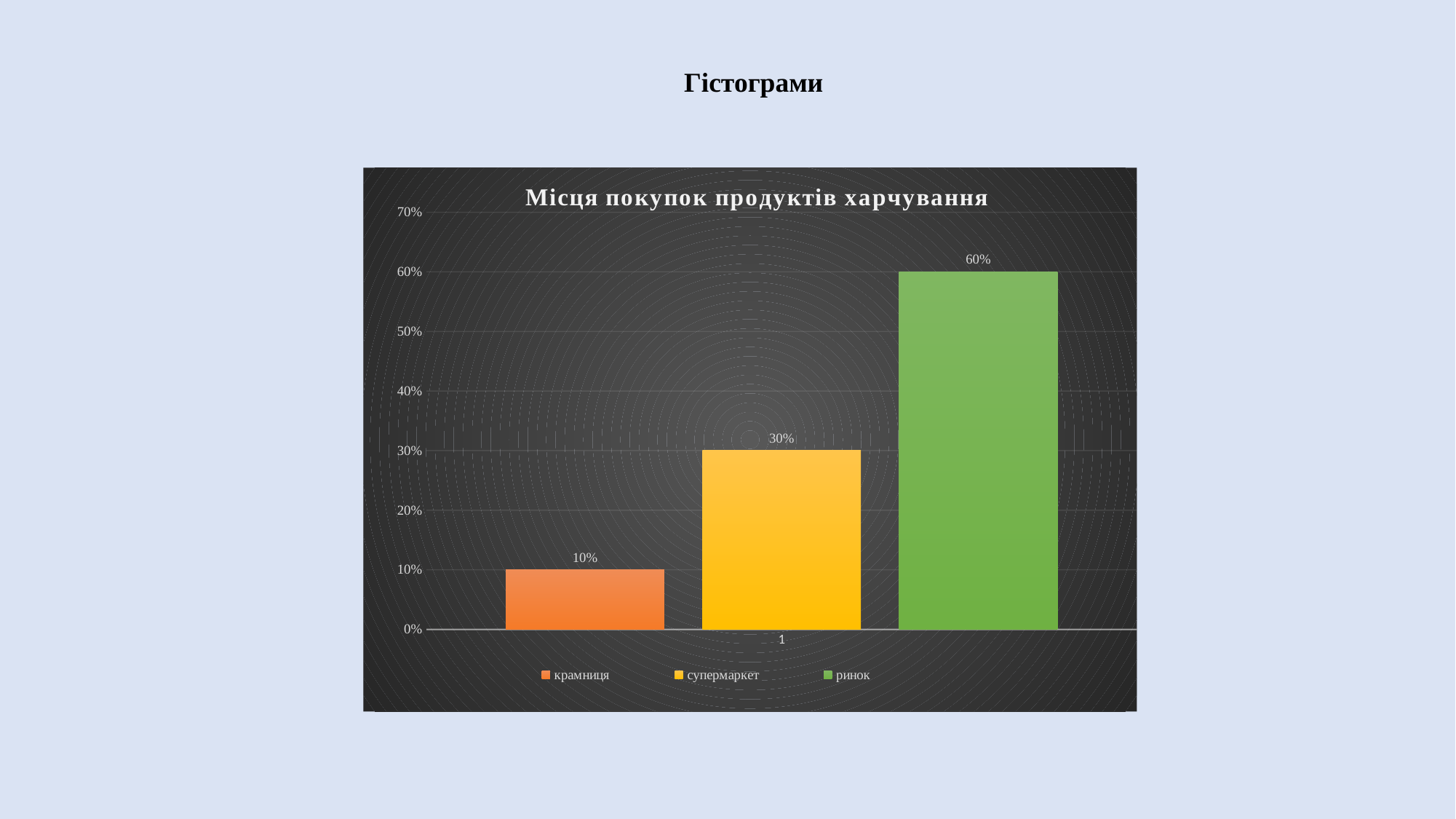
What kind of chart is shown on the slide? bar chart What is the value for супермаркет? 30% Which is larger, the value for супермаркет or the value for крамниця? супермаркет Is the value for ринок greater or less than 50%? greater What is the title of the chart? Місця покупок продуктів харчування What is the value for крамниця? 10% Which series has the highest value? ринок What is the value for ринок? 60% Which series has the lowest value? крамниця What is the difference between the values for супермаркет and крамниця? 20% How many series does the legend list? 3 What is the difference between the values for ринок and супермаркет? 30%